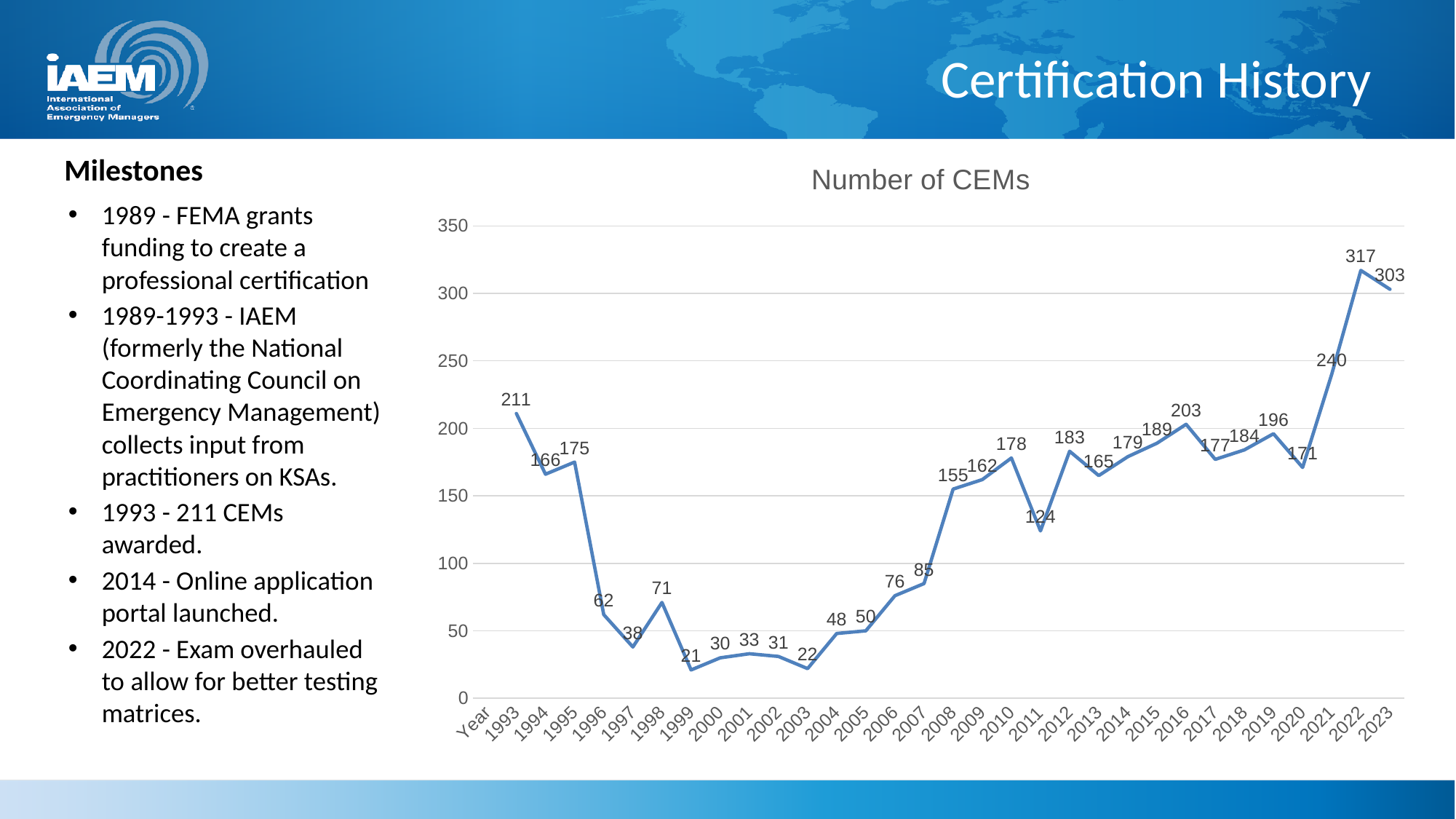
What is the number of CEMs for 2022? 317 What kind of chart is shown on the slide? line chart Does the number of CEMs rise or fall from 1993 to 1999? fall What is the difference between the number of CEMs in 2021 and in 2020? 69 What is the title of the chart? Number of CEMs Which year has the lowest number of CEMs? 1999 How many CEMs were there in 1993? 211 What is the number of CEMs for 2011? 124 Which year has the highest number of CEMs? 2022 Is the value for 2008 greater or less than 150? greater Which year had more CEMs, 2016 or 2019? 2016 What is the difference between the number of CEMs in 2022 and in 2023? 14